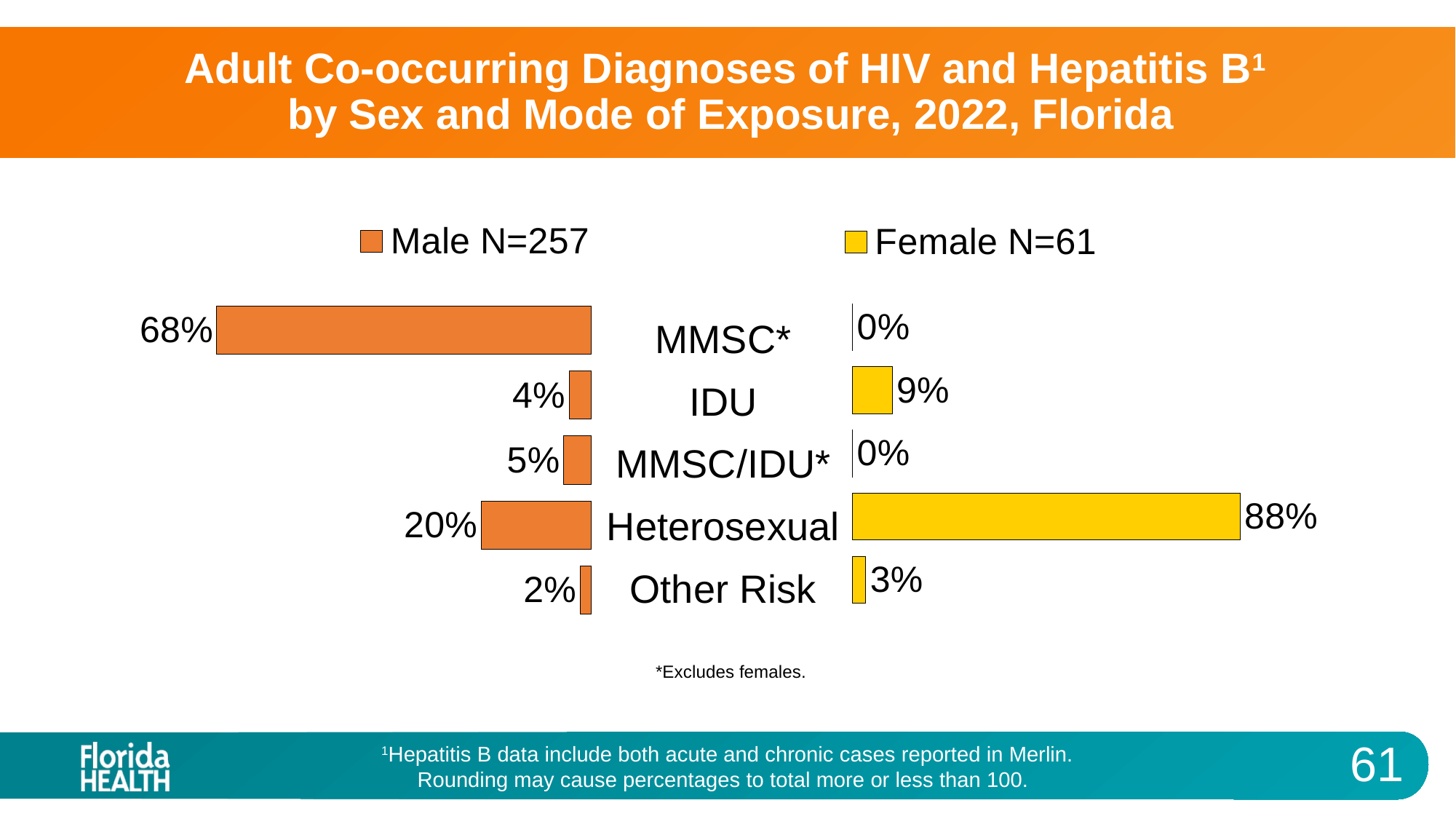
What is the N for the Male series shown in the legend? 257 What is the value for Other Risk in the Male series? 2% What percentage of females had Heterosexual as the mode of exposure? 88% How many series does the legend list? 2 Which mode of exposure has the highest percentage among females? Heterosexual Which is larger, the Male IDU percentage or the Female IDU percentage? Female IDU What is the difference between the Female and Male percentages for Heterosexual? 68% How many modes of exposure are shown on the chart? 5 Which mode of exposure has the highest percentage among males? MMSC* What is the value for IDU in the Female series? 9% What percentage of males had MMSC as the mode of exposure? 68% Which mode of exposure has the lowest percentage among males? Other Risk